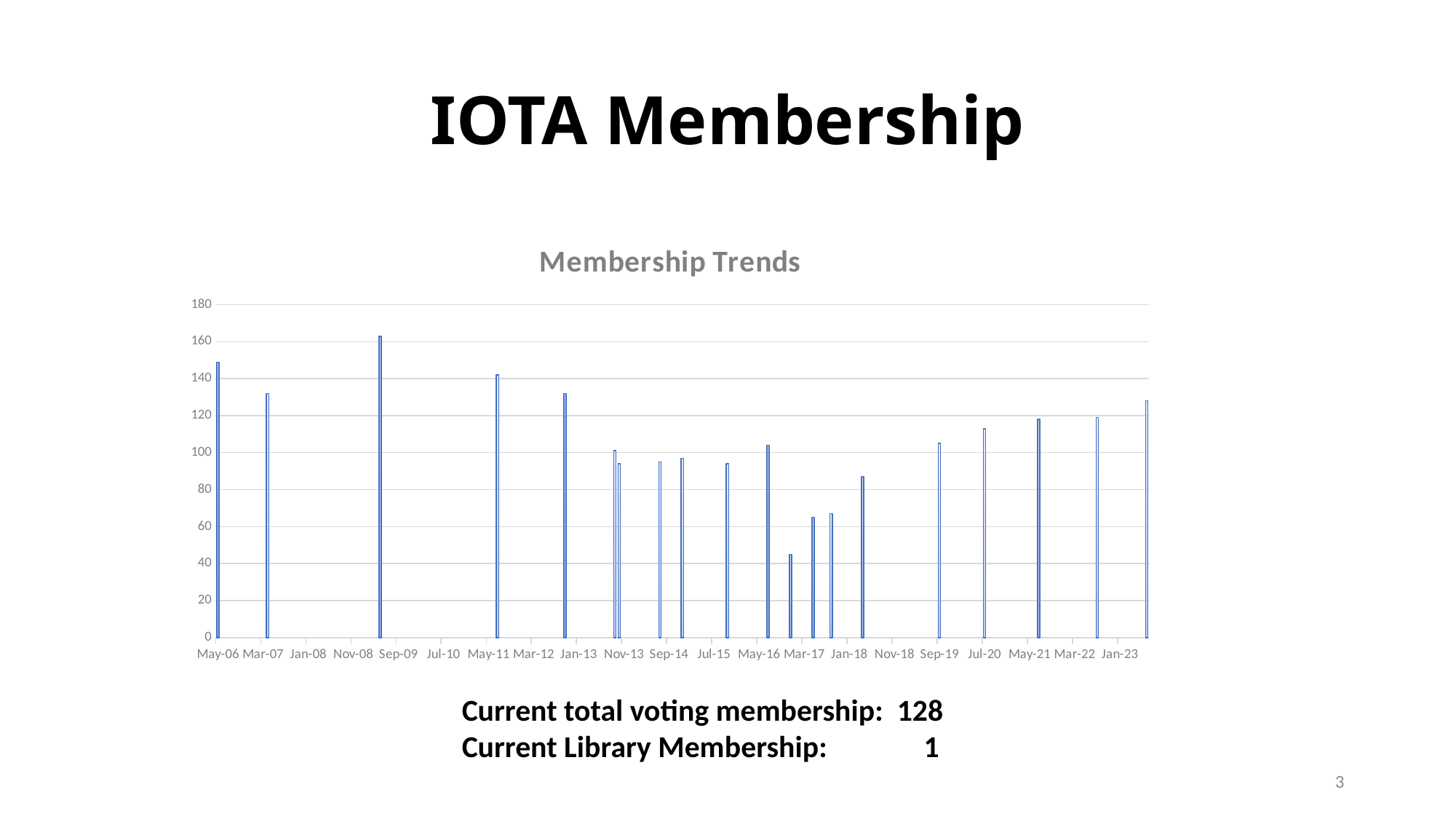
Is the value of the bar nearest Jan-18 greater or less than 100? less Is the value of the bar nearest Sep-09 greater or less than 140? greater What is the title of the chart? Membership Trends Do the bar values generally rise or fall from Mar-17 to Jan-23? rise Near which x-axis label is the tallest bar in the chart? Sep-09 Is the value of the bar nearest May-06 greater or less than 140? greater What kind of chart is shown on the slide? bar chart Which is taller: the bar nearest Sep-09 or the bar nearest May-11? the bar nearest Sep-09 Which is taller: the bar nearest May-06 or the bar nearest Jan-23? the bar nearest May-06 Near which x-axis label is the shortest bar in the chart? Mar-17